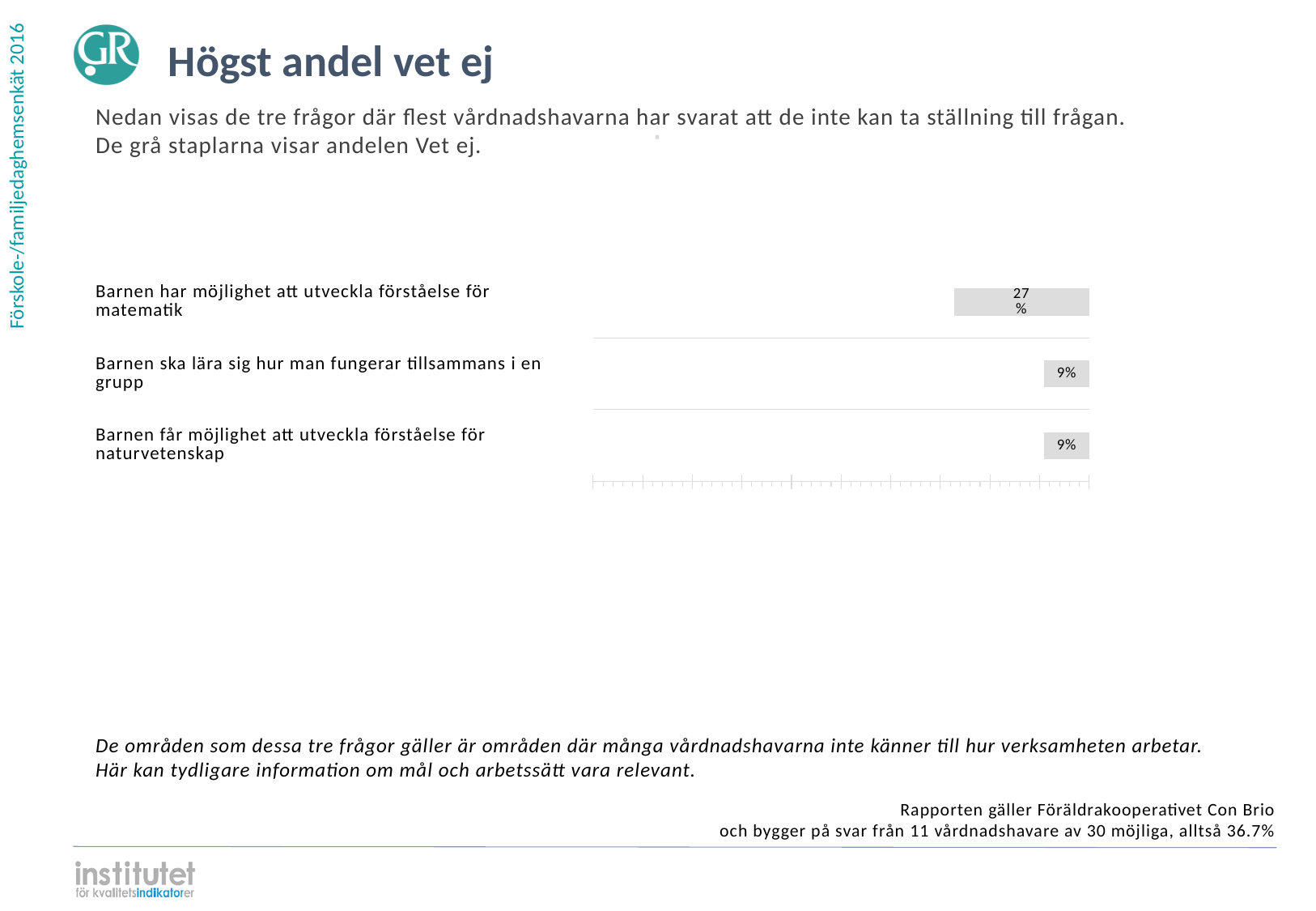
What is the Vet ej share for 'Barnen ska lära sig hur man fungerar tillsammans i en grupp'? 9% What is the title of the slide containing the chart? Högst andel vet ej What is the Vet ej share for 'Barnen har möjlighet att utveckla förståelse för matematik'? 27% What is the Vet ej share for 'Barnen får möjlighet att utveckla förståelse för naturvetenskap'? 9% What is the difference between the Vet ej share for the matematik question and the grupp question? 18 percentage points How many of the bars show a value of 9%? 2 What kind of chart is shown on the slide? Bar chart What colour are the bars in the chart? Grey How many questions (bars) are shown in the chart? 3 Which has a larger Vet ej share: the matematik question or the naturvetenskap question? The matematik question Which question has the highest Vet ej share? Barnen har möjlighet att utveckla förståelse för matematik